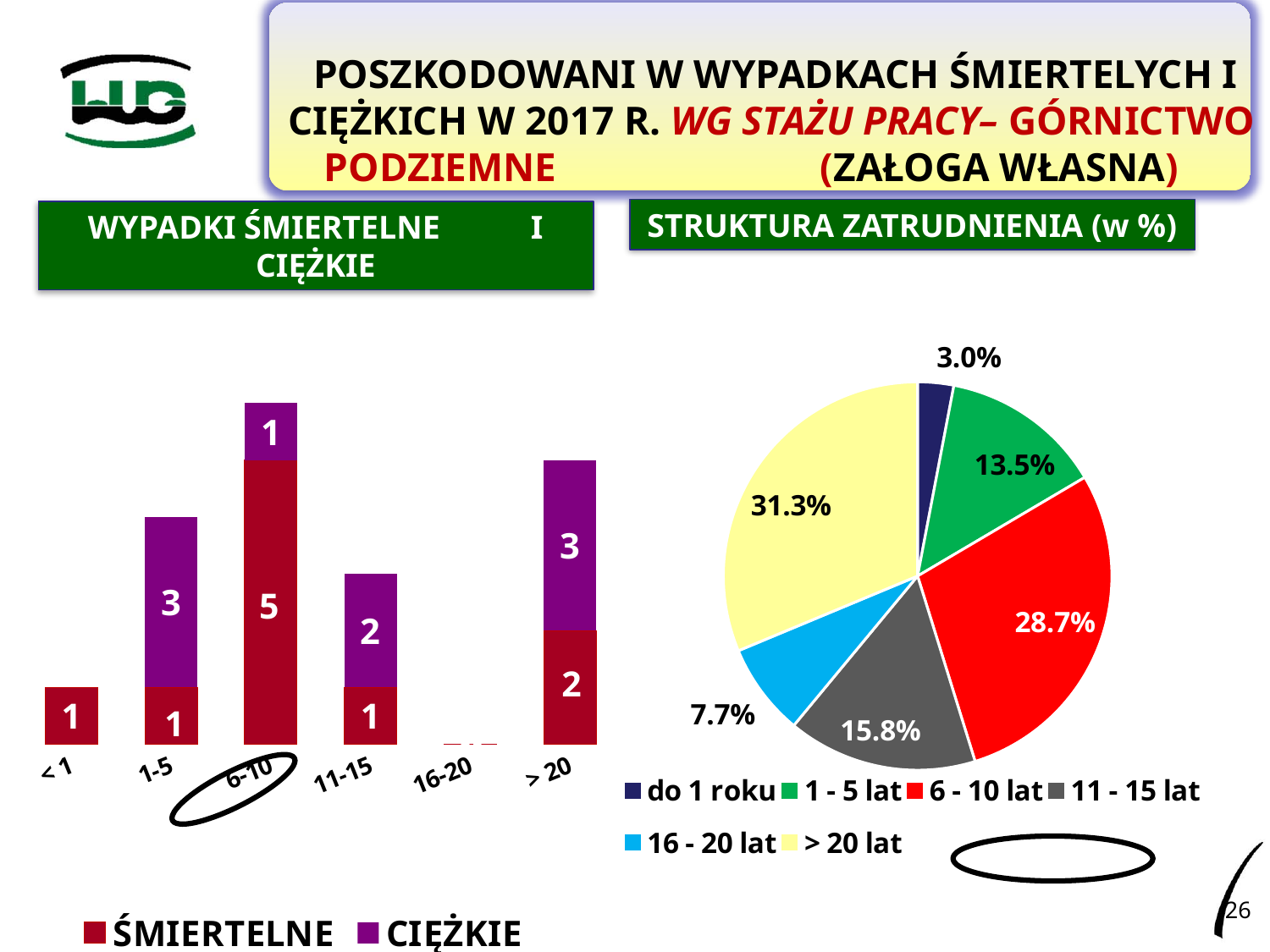
In the WYPADKI ŚMIERTELNE I CIĘŻKIE chart, what is the total of the stacked bar for the > 20 category? 5 In the STRUKTURA ZATRUDNIENIA (w %) pie chart, what is the share for 6 - 10 lat? 28.7% In the STRUKTURA ZATRUDNIENIA (w %) pie chart, how many slices are there? 6 In the WYPADKI ŚMIERTELNE I CIĘŻKIE chart, what is the total of the stacked bar for the 6-10 category? 6 What kind of chart is the WYPADKI ŚMIERTELNE I CIĘŻKIE chart? Stacked bar chart In the WYPADKI ŚMIERTELNE I CIĘŻKIE chart, how many series does the legend list? 2 In the STRUKTURA ZATRUDNIENIA (w %) pie chart, which category has the largest share? > 20 lat In the WYPADKI ŚMIERTELNE I CIĘŻKIE chart, what is the ŚMIERTELNE value for the 6-10 category? 5 In the STRUKTURA ZATRUDNIENIA (w %) pie chart, what is the difference between the shares for > 20 lat and 6 - 10 lat? 2.6% In the WYPADKI ŚMIERTELNE I CIĘŻKIE chart, what is the CIĘŻKIE value for the > 20 category? 3 In the WYPADKI ŚMIERTELNE I CIĘŻKIE chart, which category has the highest ŚMIERTELNE value? 6-10 In the STRUKTURA ZATRUDNIENIA (w %) pie chart, which category has the smallest share? do 1 roku